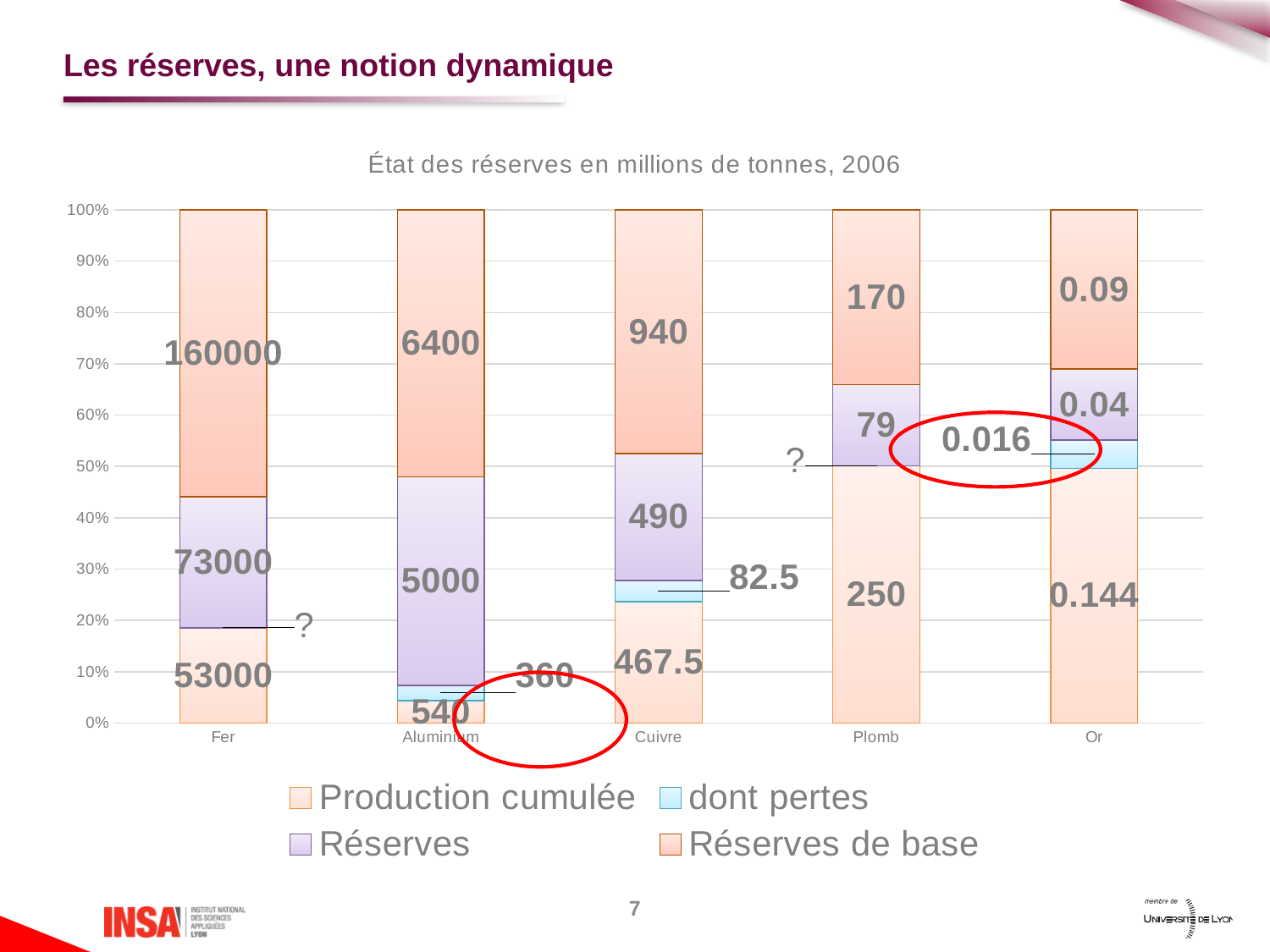
Which is larger for Fer, Réserves de base or Réserves? Réserves de base What is the value of Réserves for Cuivre? 490 What type of chart is shown on the slide? Stacked bar chart What is the value of dont pertes for Cuivre? 82.5 What is the value of Production cumulée for Aluminium? 540 How many series does the legend list? 4 What is the difference between Réserves de base and Réserves for Cuivre? 450 What is the title of the chart? État des réserves en millions de tonnes, 2006 What is the value of Réserves de base for Plomb? 170 What is the value of dont pertes for Or? 0.016 What is the value of Réserves de base for Fer? 160000 How many categories (metals) are shown on the x axis? 5